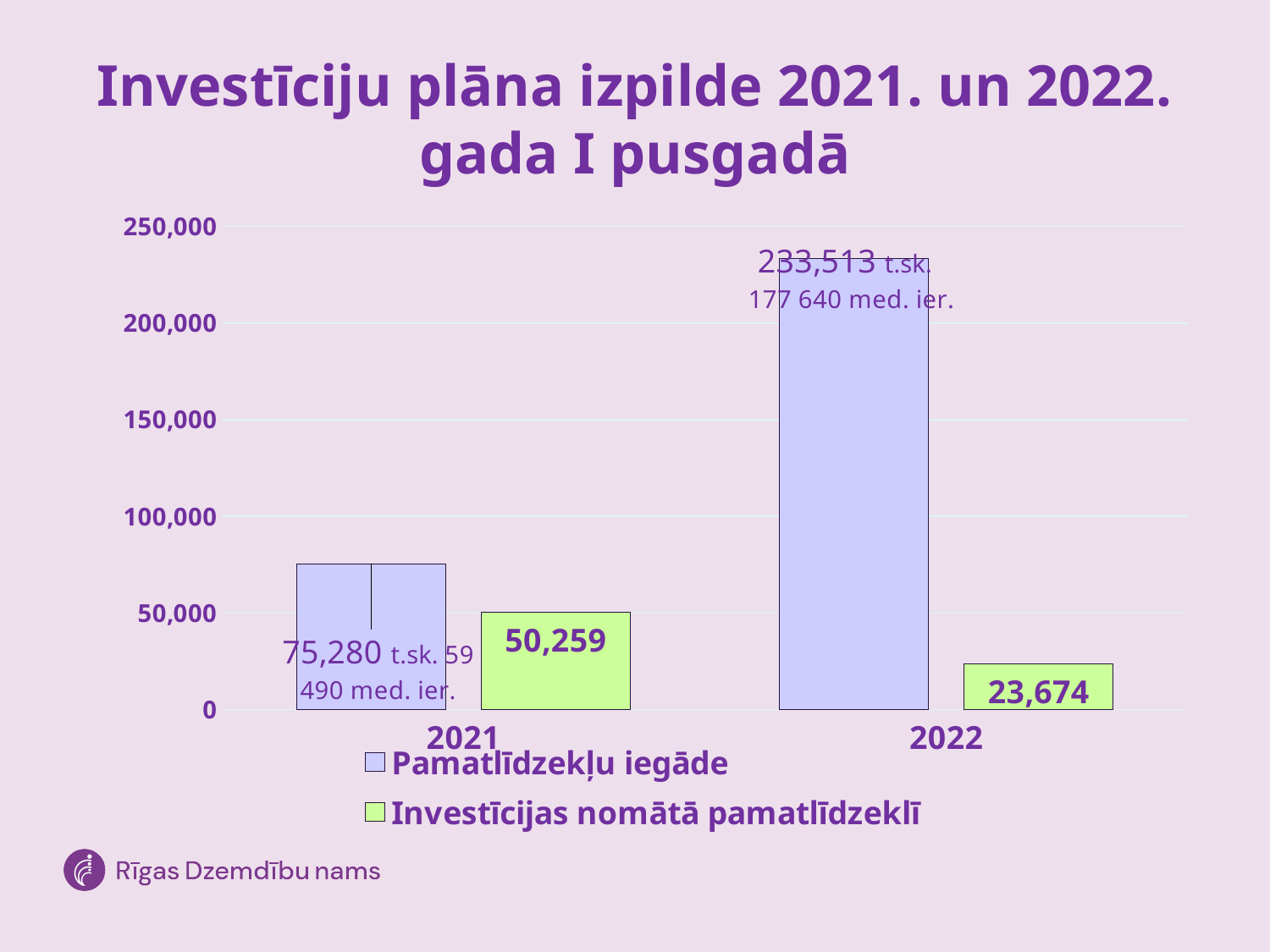
What kind of chart is shown on the slide? Bar chart Is the value for Pamatlīdzekļu iegāde in 2022 greater or less than 200,000? greater What is the difference between Investīcijas nomātā pamatlīdzeklī in 2021 and in 2022? 26,585 What is the value of Pamatlīdzekļu iegāde in 2021? 75,280 Which year has the higher value for Pamatlīdzekļu iegāde? 2022 How many series does the legend list? 2 What is the value of Investīcijas nomātā pamatlīdzeklī in 2022? 23,674 What is the difference between Pamatlīdzekļu iegāde in 2022 and in 2021? 158,233 Which year has the lower value for Investīcijas nomātā pamatlīdzeklī? 2022 What is the value of Investīcijas nomātā pamatlīdzeklī in 2021? 50,259 Does the value for Investīcijas nomātā pamatlīdzeklī rise or fall from 2021 to 2022? Fall What is the value of Pamatlīdzekļu iegāde in 2022? 233,513